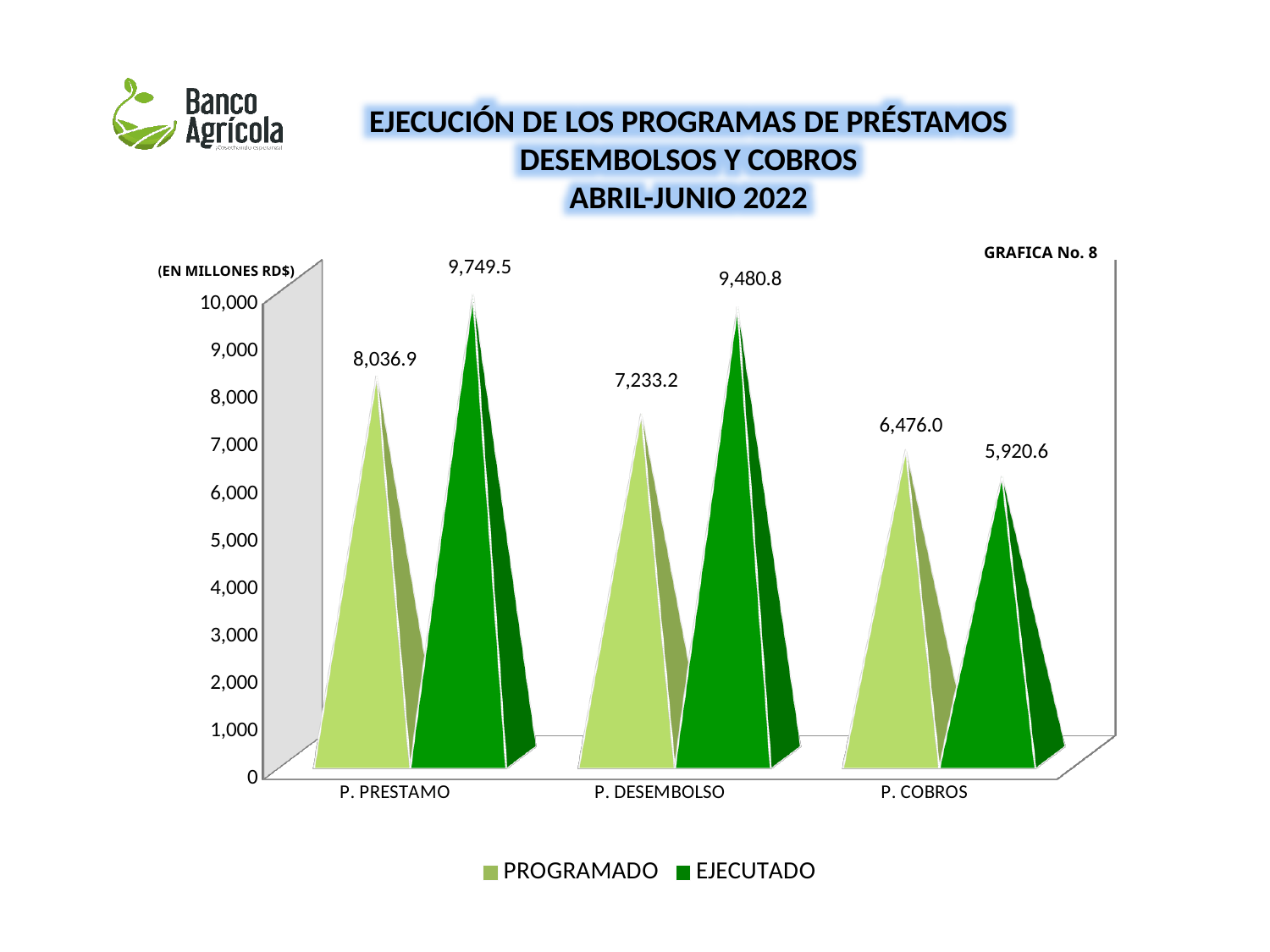
What is the PROGRAMADO value for P. PRESTAMO? 8,036.9 Is the EJECUTADO value for P. PRESTAMO greater or less than 9,000? greater What unit is stated for the values in the chart? EN MILLONES RD$ What is the difference between the PROGRAMADO and EJECUTADO values for P. COBROS? 555.4 What is the EJECUTADO value for P. DESEMBOLSO? 9,480.8 What is the EJECUTADO value for P. COBROS? 5,920.6 For P. COBROS, which is larger, PROGRAMADO or EJECUTADO? PROGRAMADO How many categories are shown on the x axis? 3 What is the difference between the EJECUTADO and PROGRAMADO values for P. DESEMBOLSO? 2,247.6 Which category has the lowest PROGRAMADO value? P. COBROS Which category has the highest EJECUTADO value? P. PRESTAMO How many series does the legend list? 2